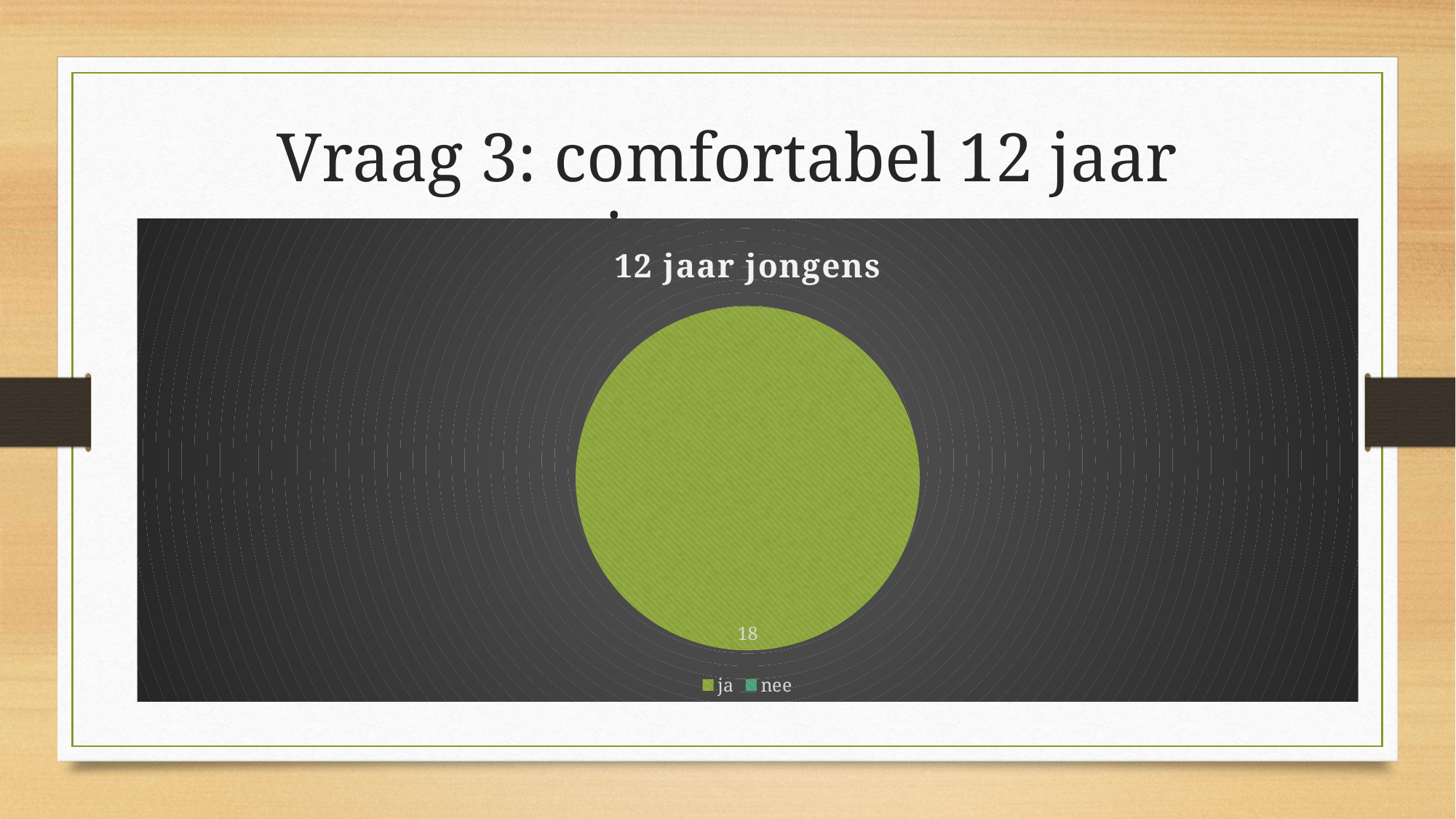
What value is shown for the 'ja' slice? 18 Is the value for 'ja' greater or less than 10? greater What colour is used for the 'ja' category in the chart? green What is the title of the chart? 12 jaar jongens Which category has the smallest slice of the pie? nee How many entries does the chart legend list? 2 Which category has the largest slice of the pie? ja What kind of chart is shown on the slide? pie chart Which is larger, the slice for 'ja' or the slice for 'nee'? ja